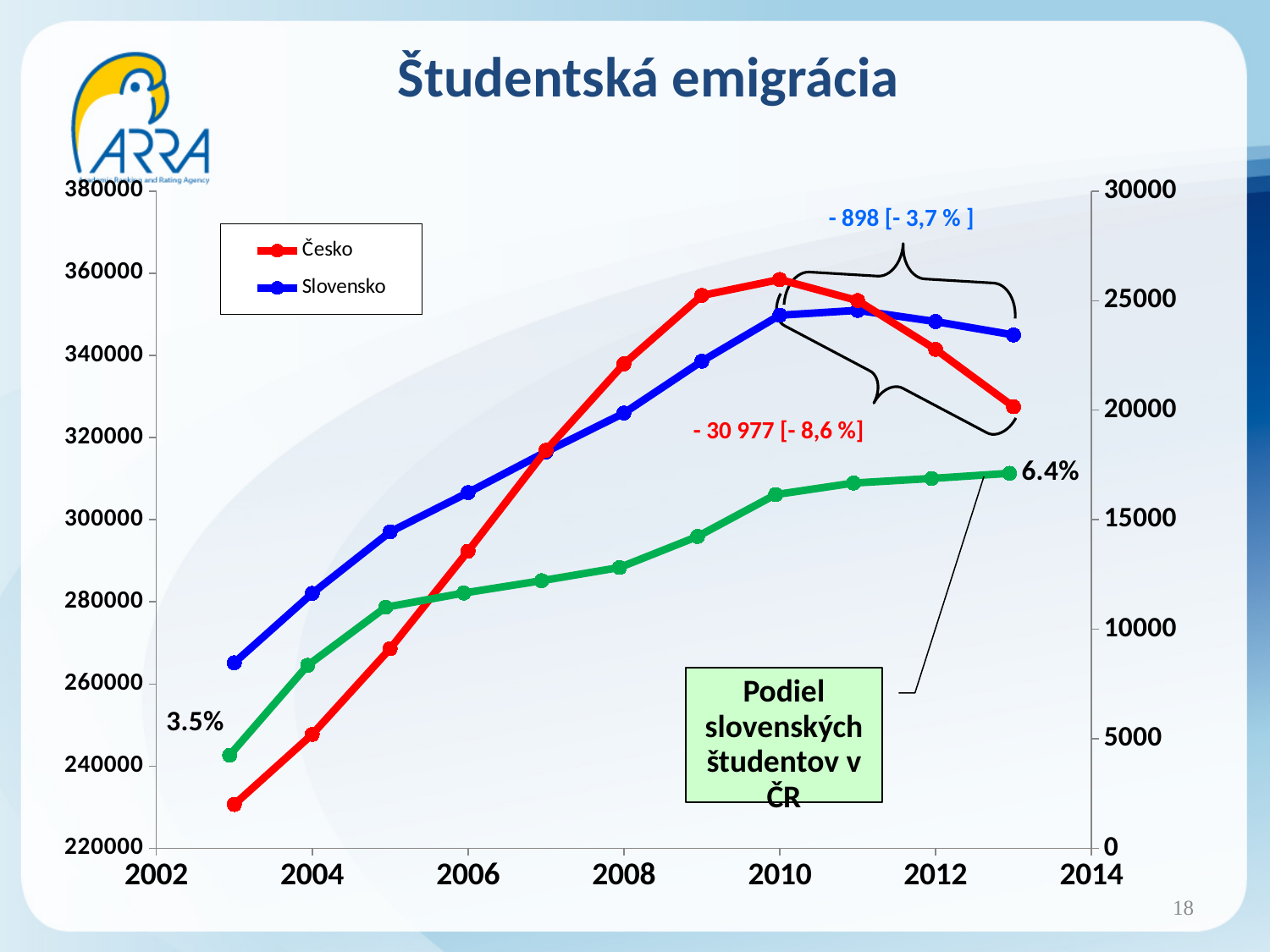
What percentage is labelled at the start (2003) of the green line showing the share of Slovak students in ČR? 3.5% What change is annotated in red for the Česko series? - 30 977 [- 8,6 %] How many data points does the Česko line have? 11 Is the value for Česko in 2003 greater or less than 240000 on the left axis? less Is the value for Česko in 2010 greater or less than 340000 on the left axis? greater How many series does the legend list? 2 In which year does the Česko line reach its highest value? 2010 What kind of chart is shown on the slide? line chart In 2009, which series has the higher value, Česko or Slovensko? Česko Does the Česko line rise or fall between 2010 and 2013? fall What percentage is labelled at the end (2013) of the green line showing the share of Slovak students in ČR? 6.4%